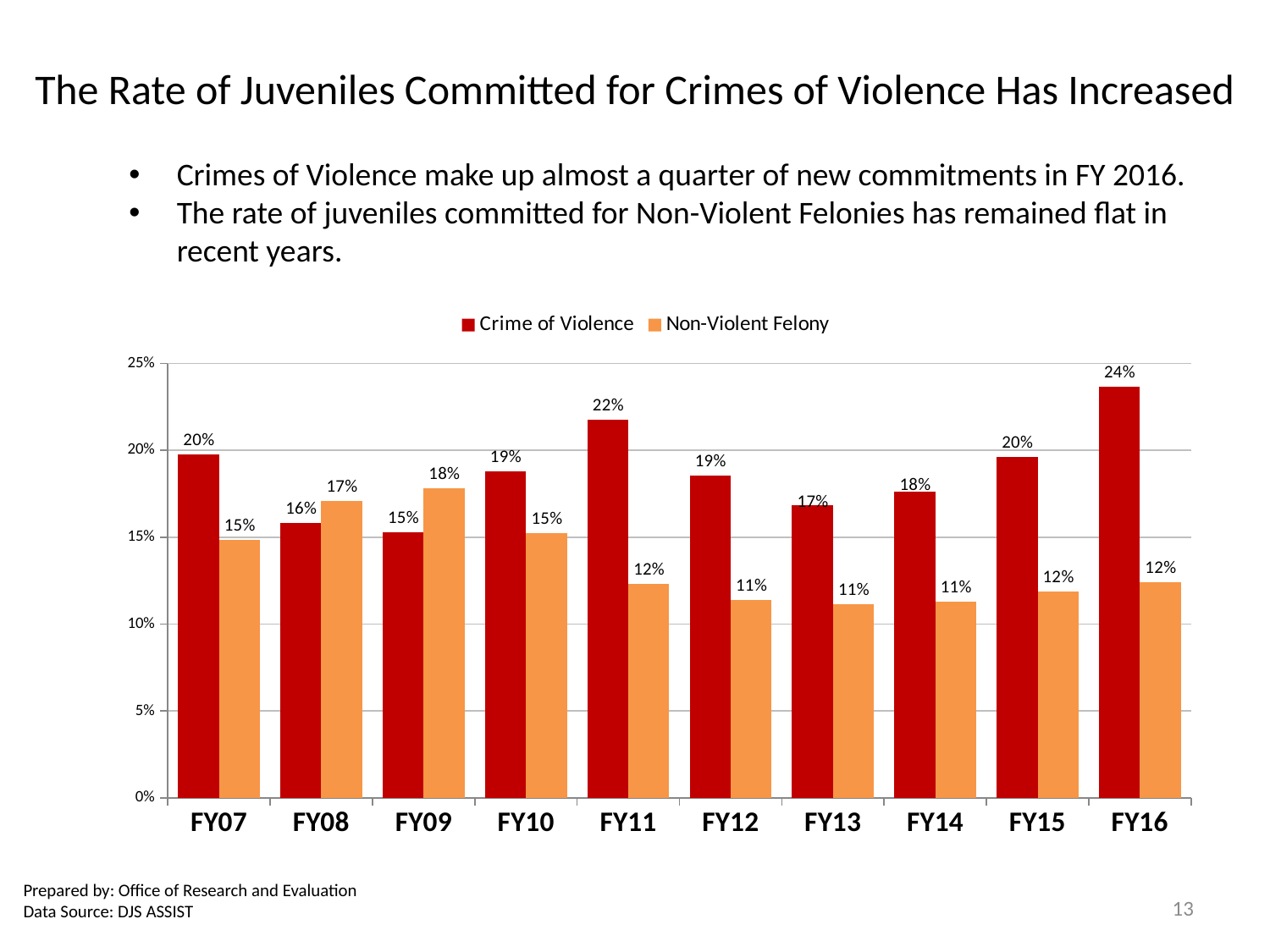
In FY09, which series has the larger value, Crime of Violence or Non-Violent Felony? Non-Violent Felony What is the value for Non-Violent Felony in FY09? 18% In which fiscal year is the Crime of Violence value highest? FY16 How many fiscal years are shown on the x axis? 10 What kind of chart is shown on the slide? Bar chart How many series does the legend list? 2 What is the value for Non-Violent Felony in FY13? 11% In which fiscal year is the Non-Violent Felony value highest? FY09 What is the value for Crime of Violence in FY16? 24% What is the difference between the Crime of Violence and Non-Violent Felony values in FY16? 12 percentage points What is the value for Crime of Violence in FY11? 22% In which fiscal year is the Crime of Violence value lowest? FY09